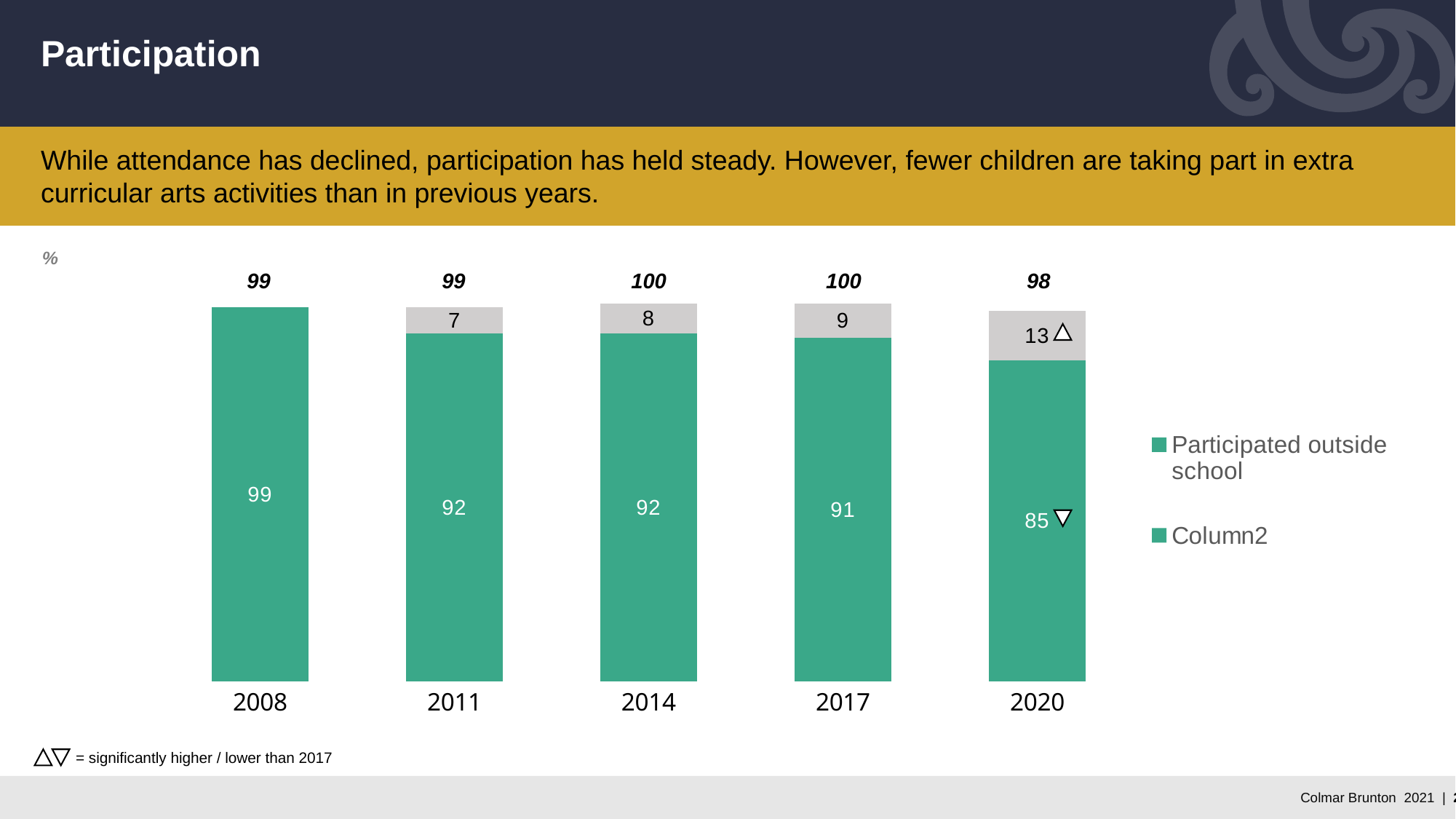
Is the grey segment larger in 2011 or in 2020? 2020 What is the difference between the 'Participated outside school' values for 2017 and 2020? 6 Does the 'Participated outside school' value rise or fall from 2008 to 2020? Fall What is the value of the grey (top) segment in 2017? 9 What is the total shown above the 2014 bar? 100 What is the value for 'Participated outside school' in 2020? 85 What kind of chart is shown on the slide? Stacked bar chart How many years are shown on the x axis of the chart? 5 How many series does the chart legend list? 2 Which year has the lowest value for 'Participated outside school'? 2020